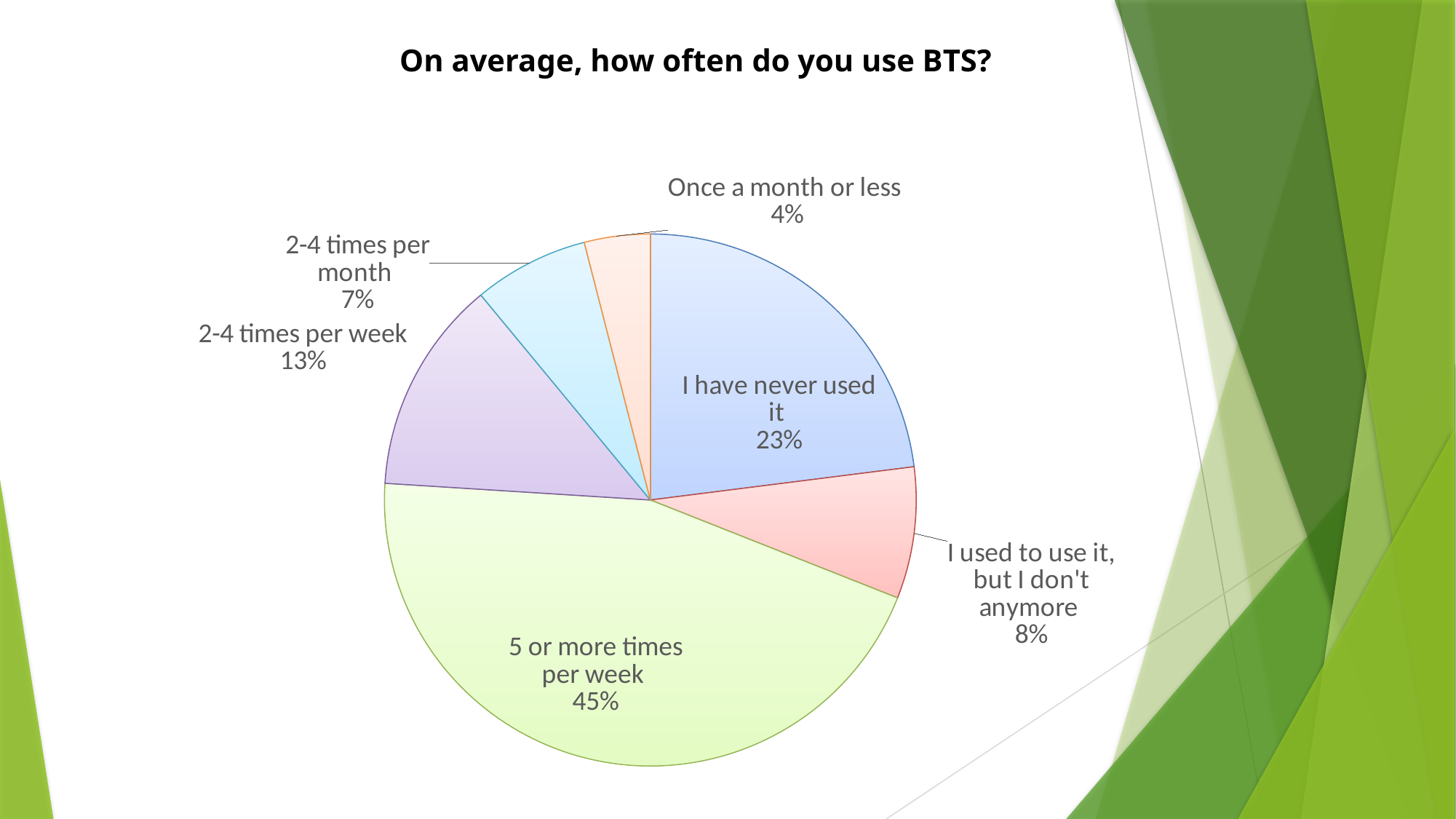
What percentage of respondents use BTS 5 or more times per week? 45% What percentage of respondents use BTS 2-4 times per week? 13% What is the difference in percentage points between '5 or more times per week' and 'I have never used it'? 22 What kind of chart is shown on the slide? pie chart How many categories (slices) does the pie chart have? 6 Which category has the largest share of the pie? 5 or more times per week What percentage of respondents use BTS once a month or less? 4% What percentage of respondents have never used BTS? 23% What is the title of the chart? On average, how often do you use BTS? Which category has the smallest share of the pie? Once a month or less Which is larger: the share for '2-4 times per week' or the share for '2-4 times per month'? 2-4 times per week What is the combined share of '2-4 times per month' and 'Once a month or less'? 11%